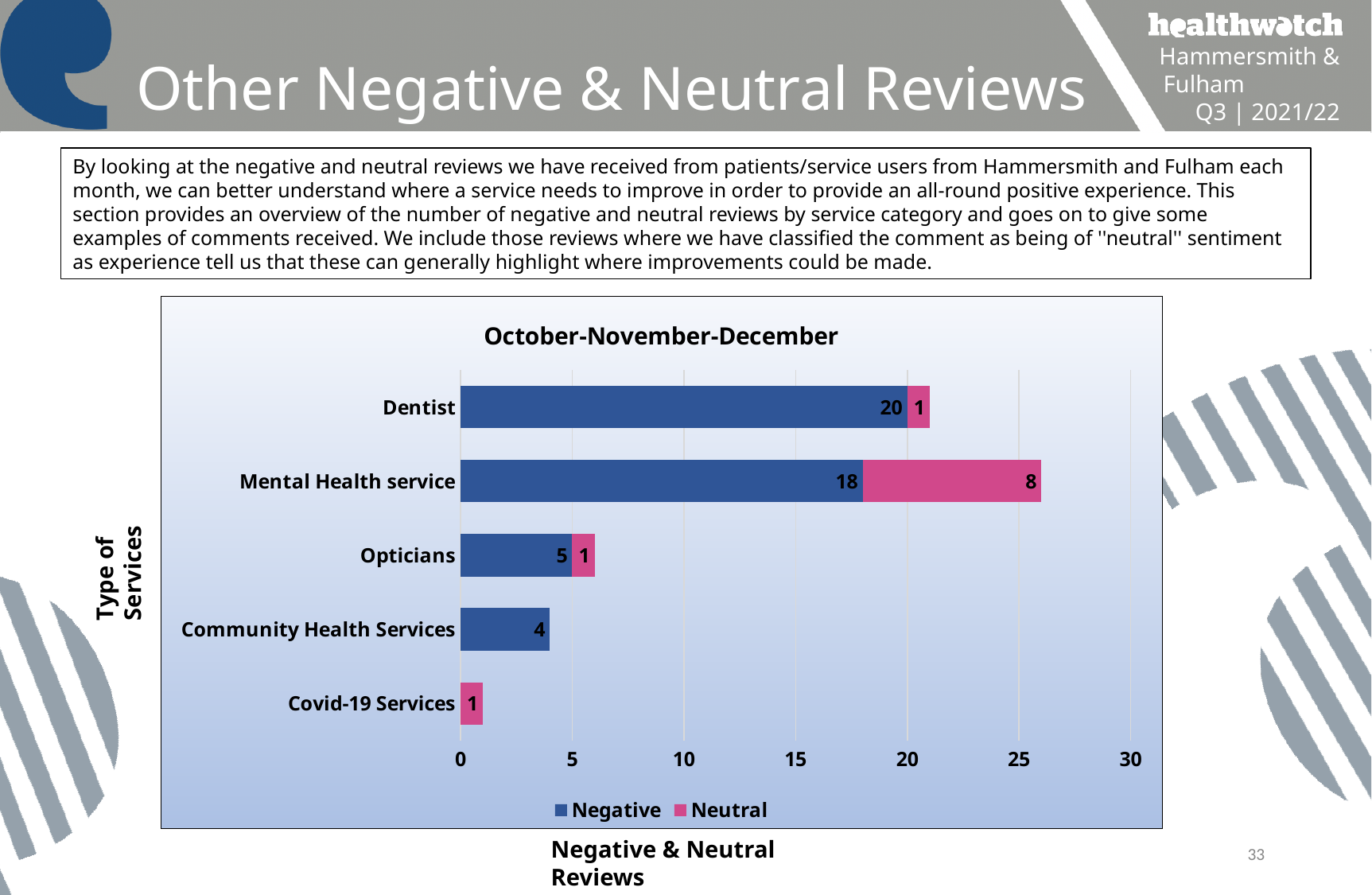
Which category has the highest Negative value? Dentist What is the Neutral value for Mental Health service? 8 What is the Neutral value for Covid-19 Services? 1 What is the total of the stacked bar for Mental Health service? 26 What is the Negative value for Dentist? 20 How many service categories are shown on the chart? 5 Which is larger, the Negative value for Opticians or the Negative value for Community Health Services? Opticians Which category has the highest Neutral value? Mental Health service What is the total of the stacked bar for Opticians? 6 What is the difference between the Negative values for Dentist and Mental Health service? 2 How many series does the legend list? 2 What is the Negative value for Community Health Services? 4